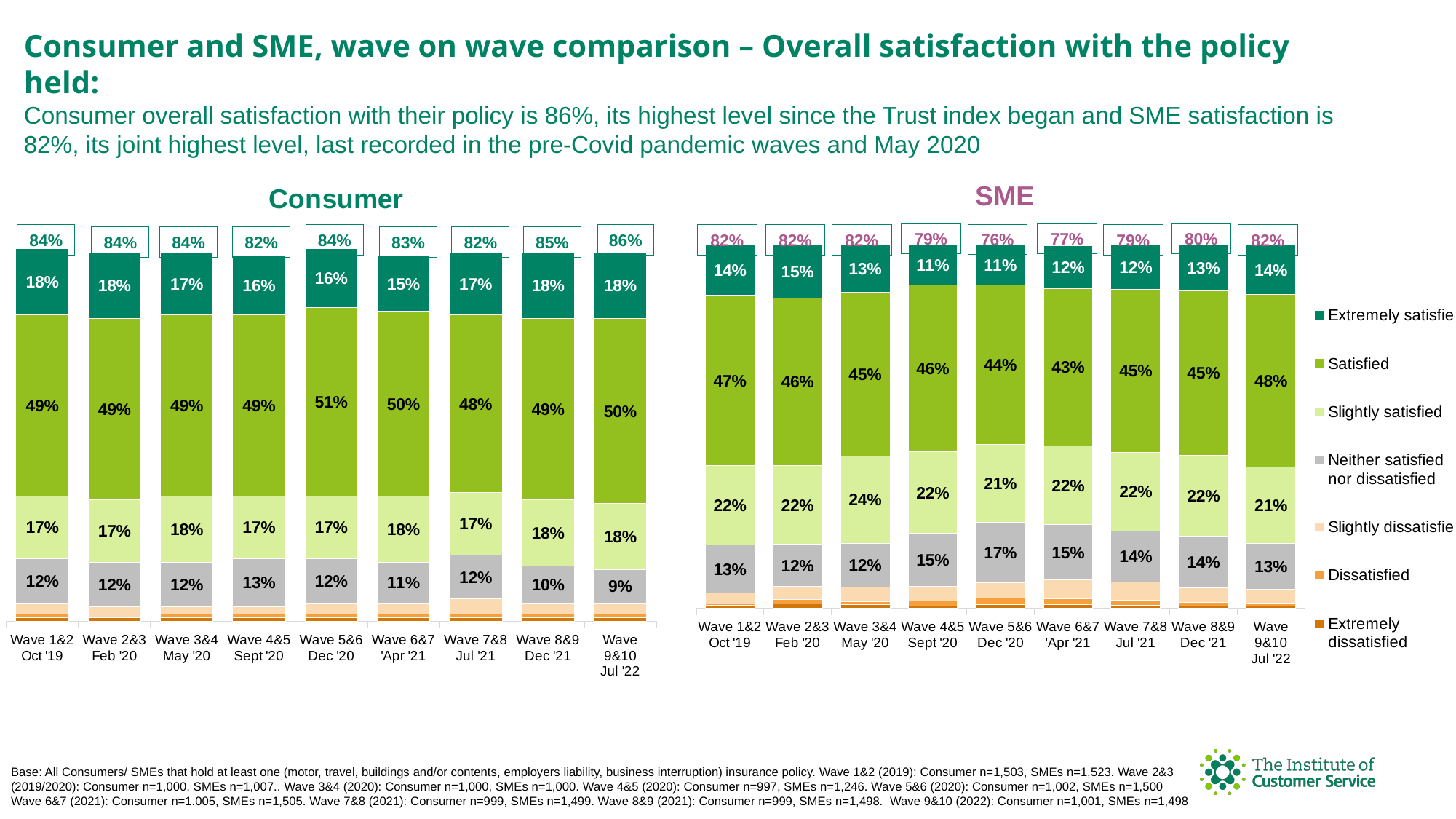
In the SME chart, which wave has the lowest overall satisfaction figure shown above the bars? Wave 5&6 Dec '20 How many waves are plotted in the Consumer chart? 9 In the SME chart, what is the Neither satisfied nor dissatisfied value for Wave 5&6 Dec '20? 17% In the Consumer chart, what is the Neither satisfied nor dissatisfied value for Wave 8&9 Dec '21? 10% In the Consumer chart, what percentage of respondents were Extremely satisfied in Wave 9&10 Jul '22? 18% What type of chart is used for the Consumer and SME data? Stacked bar chart In the Consumer chart, what is the difference between the Satisfied values for Wave 5&6 Dec '20 and Wave 7&8 Jul '21? 3% In the Consumer chart, which wave has the highest overall satisfaction figure shown above the bars? Wave 9&10 Jul '22 In the SME chart, what is the difference between the Slightly satisfied values for Wave 3&4 May '20 and Wave 9&10 Jul '22? 3% In the SME chart, what percentage of respondents were Satisfied in Wave 9&10 Jul '22? 48% How many series does the legend list? 7 In the SME chart, which is larger: the Extremely satisfied value for Wave 2&3 Feb '20 or for Wave 4&5 Sept '20? Wave 2&3 Feb '20